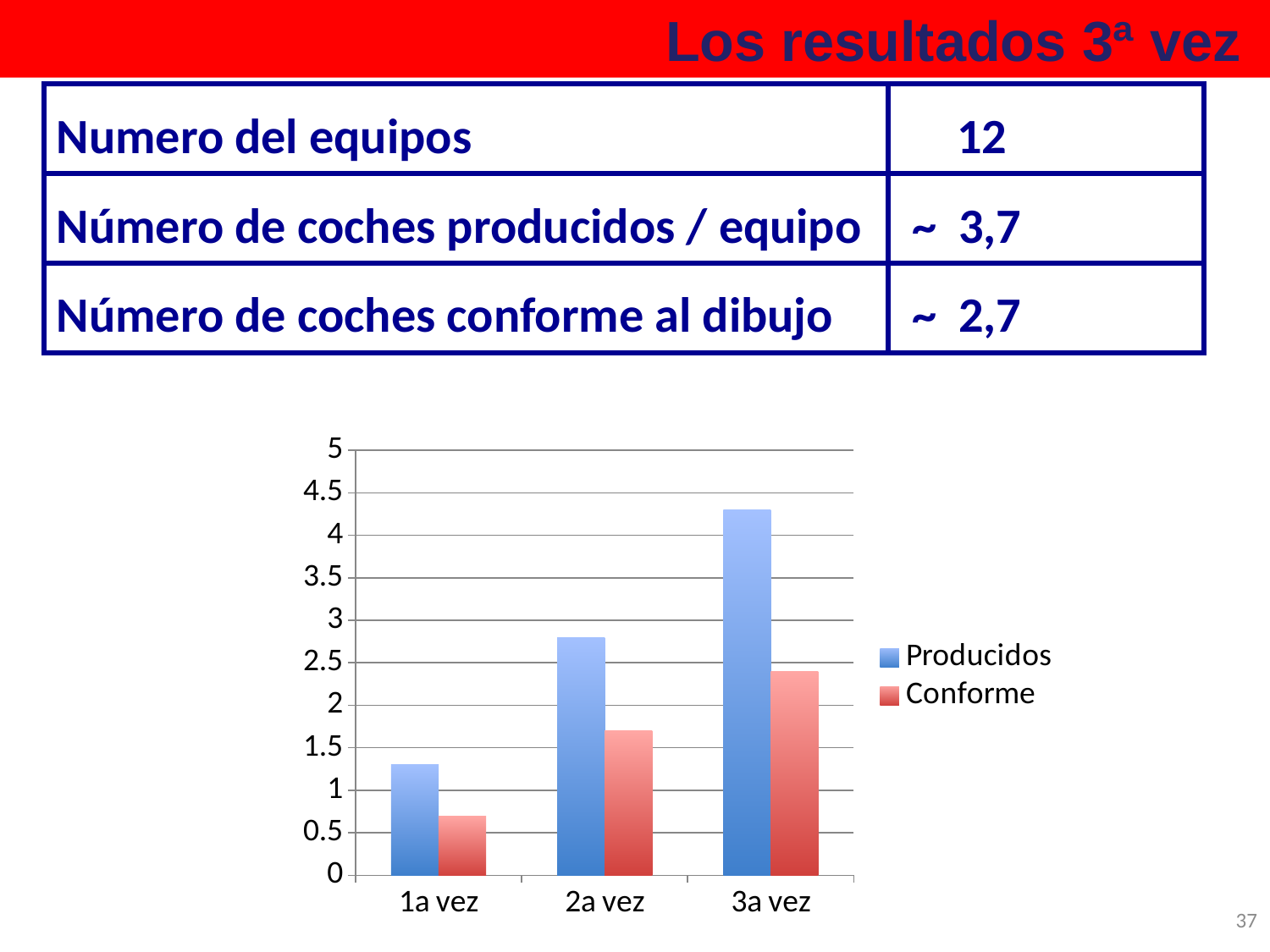
Is the Conforme value for 1a vez greater or less than 1? less How many categories are shown on the x axis of the chart? 3 Do the Producidos values rise or fall from 1a vez to 3a vez? rise Which category has the lowest Conforme value? 1a vez For 2a vez, which is larger: Producidos or Conforme? Producidos What kind of chart is shown on the slide? bar chart Is the Producidos value for 3a vez greater or less than 4? greater Is the Conforme value for 2a vez greater or less than 1.5? greater What colour are the Conforme bars in the chart? red How many series does the chart legend list? 2 Which category has the highest Producidos value? 3a vez